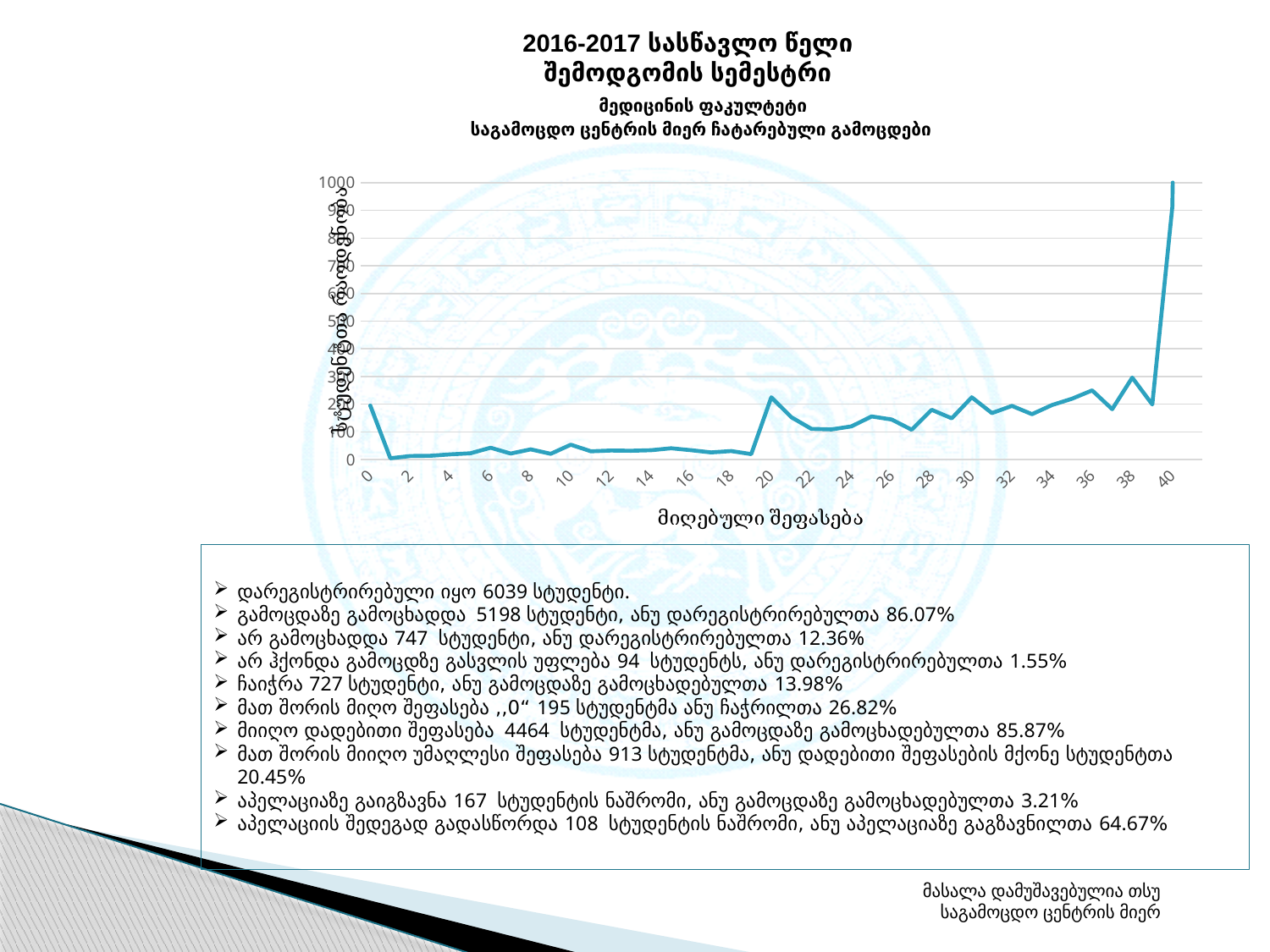
Is the value at score 20 greater or less than 400? less Is the value at score 10 greater or less than 100? less Does the line generally rise or fall between score 20 and score 40? rise At which x-axis value (score) does the line reach its highest point? 40 What kind of chart is shown on the slide? line chart Which has the larger value, score 0 or score 10? 0 Is the value at score 40 greater or less than 900? greater What is the highest tick value shown on the y axis? 1000 What is the highest tick value shown on the x axis? 40 Which has the larger value, score 40 or score 20? 40